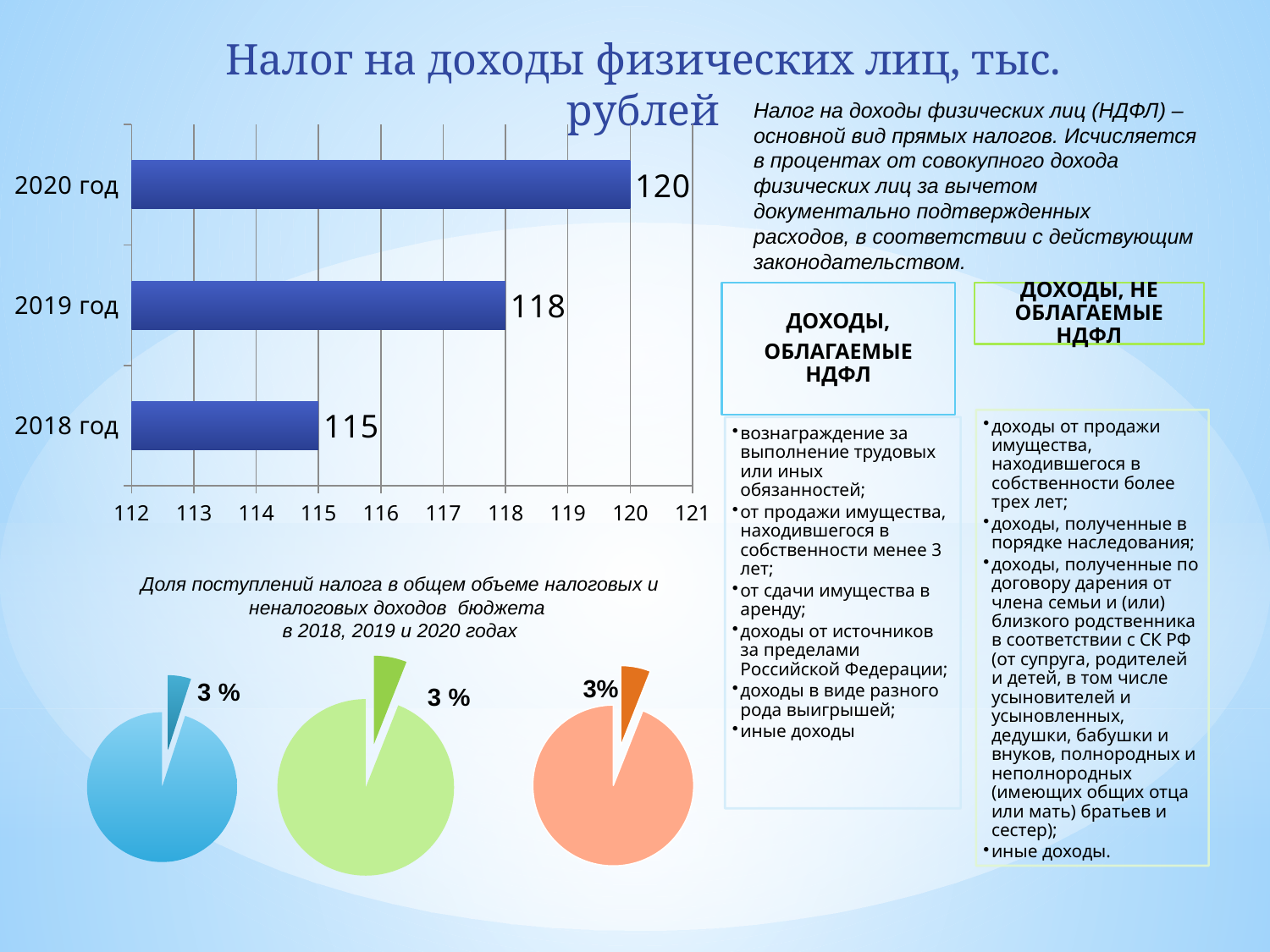
In the bar chart, what is the value for 2018 год? 115 What type of chart is the chart at the top left of the slide? bar chart In the bar chart, which year has the highest value? 2020 год In the bar chart, what is the value for 2019 год? 118 In the bar chart, what is the difference between the values for 2020 год and 2018 год? 5 How many bars are shown in the bar chart? 3 In the bar chart, what is the difference between the values for 2019 год and 2018 год? 3 In the leftmost pie chart at the bottom of the slide, what share is shown for the small highlighted slice? 3 % Do the values in the bar chart rise or fall from 2018 год to 2020 год? rise In the bar chart, which year has the lowest value? 2018 год In the bar chart, which is larger, the value for 2019 год or the value for 2018 год? 2019 год In the bar chart, what is the value for 2020 год? 120